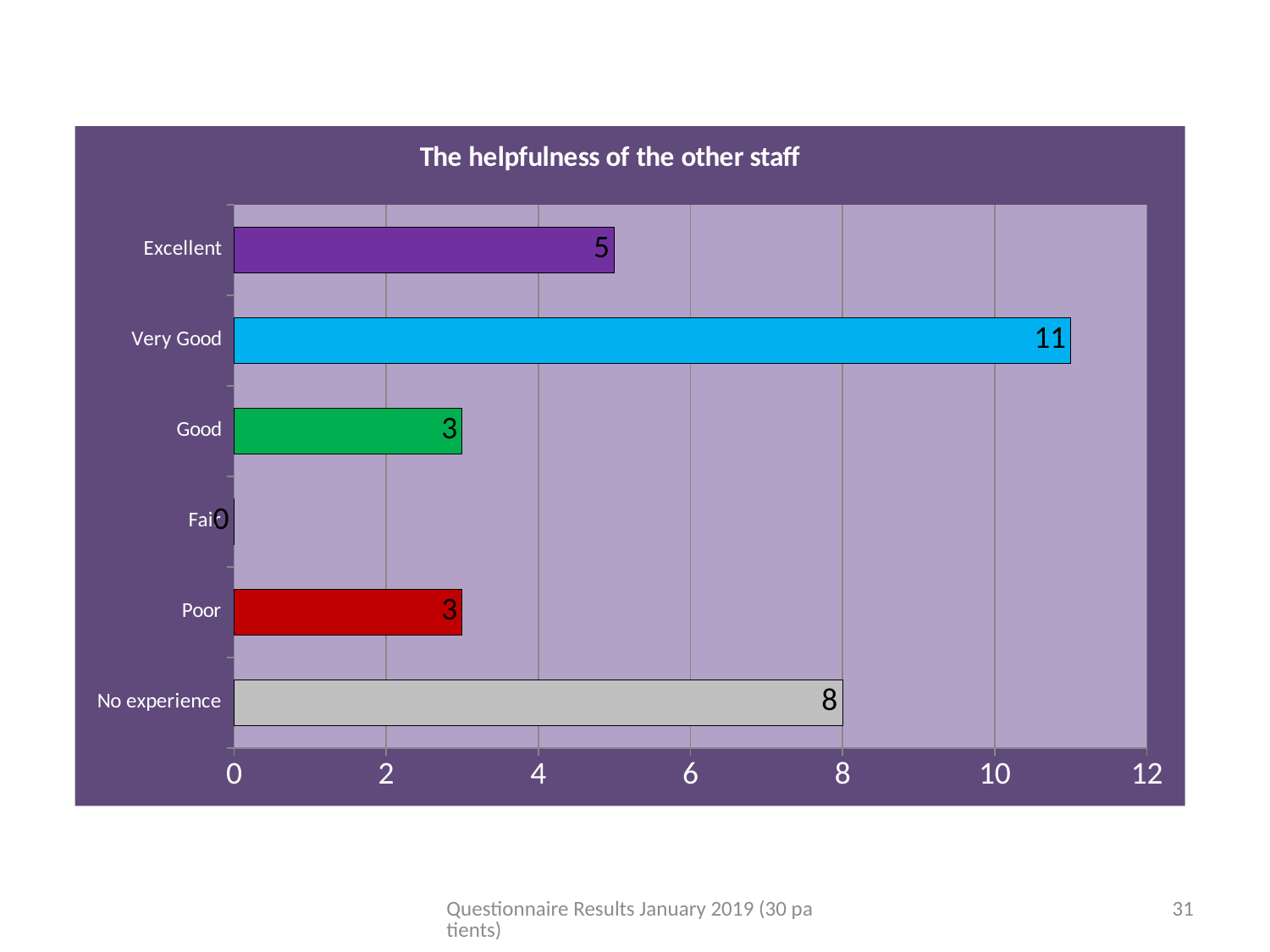
What is the value for Very Good? 11 What is the value for Excellent? 5 What kind of chart is shown? Bar chart What is the title of the chart? The helpfulness of the other staff Which category has the highest value? Very Good What is the difference between the values for Very Good and No experience? 3 Which is larger, the value for Excellent or the value for Good? Excellent Is the value for Very Good greater or less than 10? greater What is the value for No experience? 8 What is the value for Fair? 0 How many categories are shown on the chart? 6 Which category has the lowest value? Fair